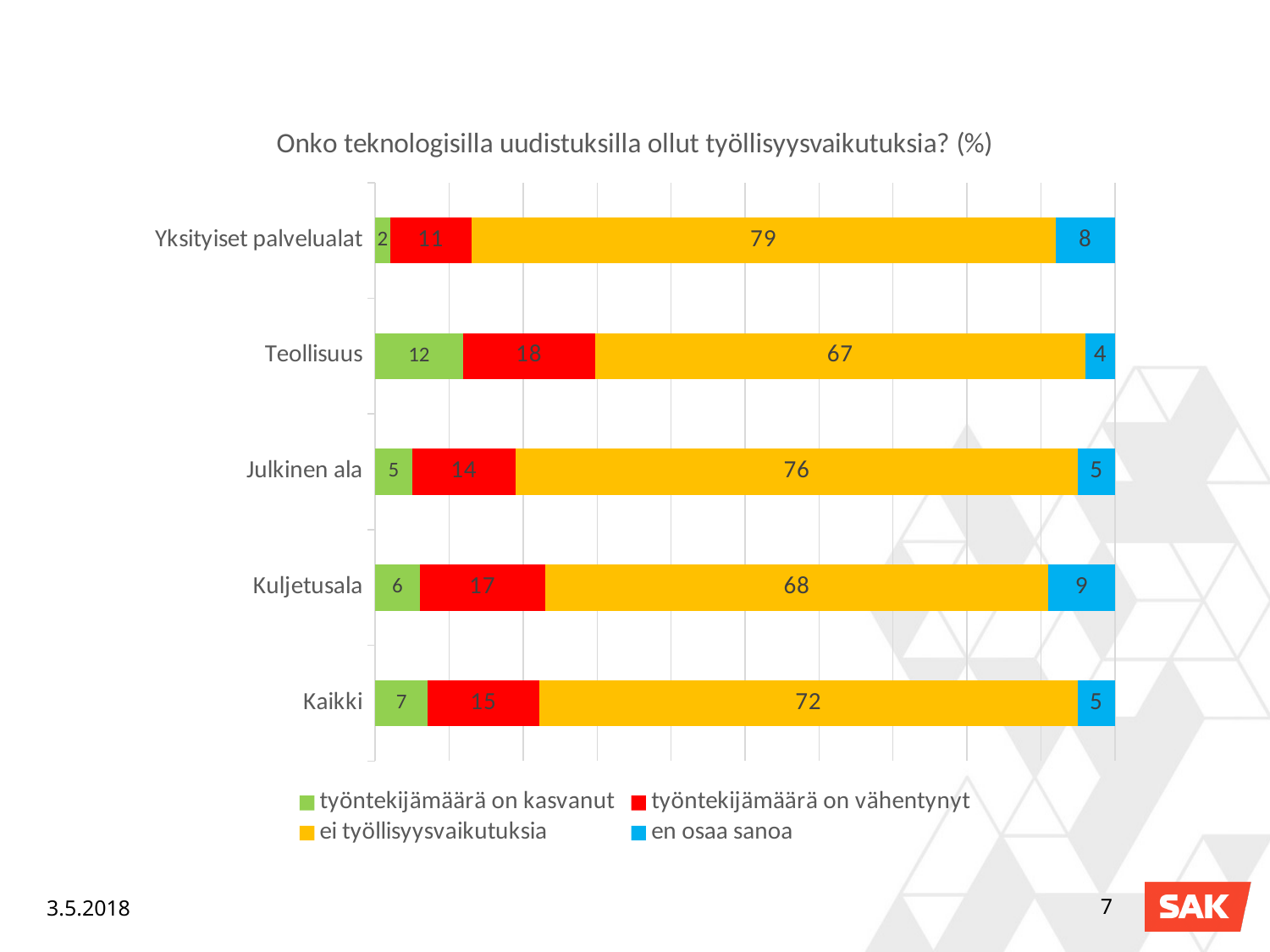
What is the total of the stacked bar for Teollisuus? 101 Which is larger: the "työntekijämäärä on vähentynyt" value for Kuljetusala or for Julkinen ala? Kuljetusala How many series does the legend list? 4 Which category has the highest value for "ei työllisyysvaikutuksia"? Yksityiset palvelualat How many categories are shown on the chart? 5 What is the difference between the "ei työllisyysvaikutuksia" values for Julkinen ala and Teollisuus? 9 What is the value for "työntekijämäärä on kasvanut" for Kaikki? 7 Which category has the lowest value for "työntekijämäärä on kasvanut"? Yksityiset palvelualat What is the value for "ei työllisyysvaikutuksia" for Yksityiset palvelualat? 79 What is the value for "työntekijämäärä on vähentynyt" for Teollisuus? 18 What kind of chart is shown on the slide? Stacked bar chart What is the value for "en osaa sanoa" for Kuljetusala? 9